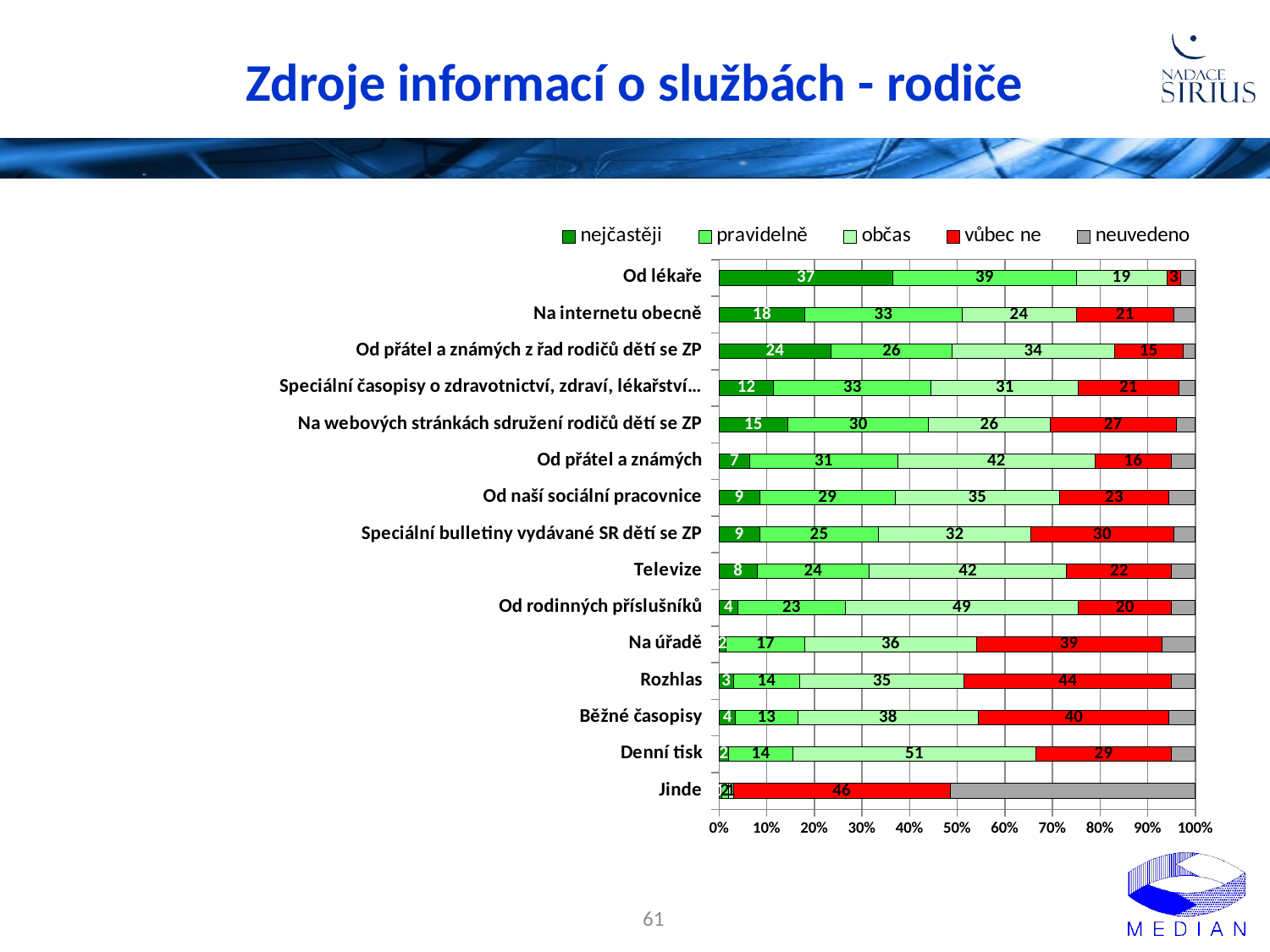
What kind of chart is shown on the slide? Stacked bar chart Which category has the lowest "vůbec ne" value? Od lékaře Which category has the highest "nejčastěji" value? Od lékaře How many series does the legend list? 5 Which has the larger "pravidelně" value: "Na internetu obecně" or "Televize"? Na internetu obecně What is the difference between the "občas" values for "Od rodinných příslušníků" and "Od lékaře"? 30 How many categories are shown on the chart? 15 What is the value of the "vůbec ne" segment for "Rozhlas"? 44 What is the value of the "nejčastěji" segment for "Od lékaře"? 37 Is the "neuvedeno" value for "Jinde" greater or less than 40%? greater Which series is shown in red in the legend? vůbec ne What is the value of the "občas" segment for "Denní tisk"? 51